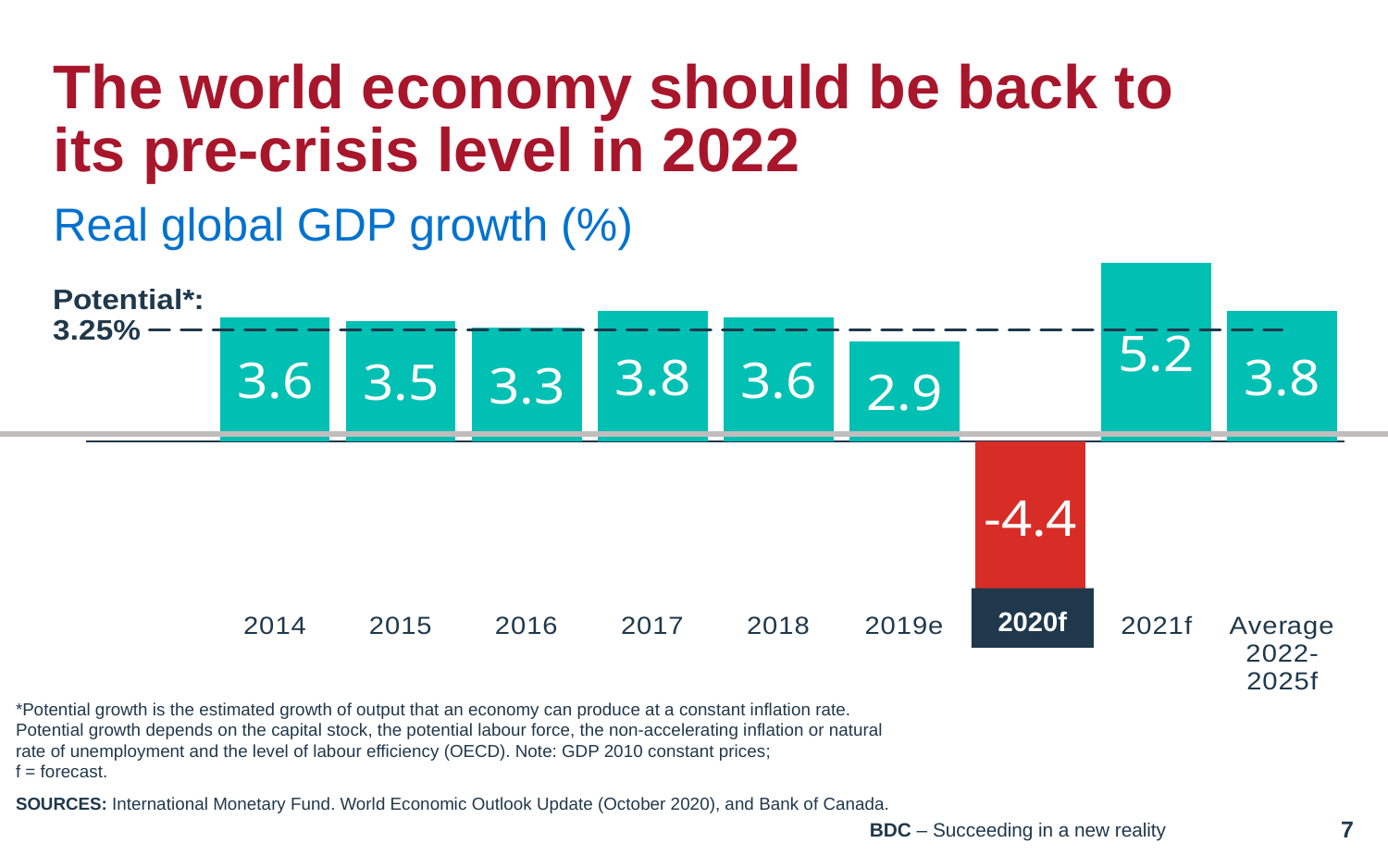
Which bar on the chart is coloured red rather than teal? 2020f Which is larger, the value for 2016 or the value for 2018? 2018 What is the real global GDP growth value shown for 2020f? -4.4 What is the difference between the values for 2021f and 2019e? 2.3 Do the values fall or rise from 2017 to 2019e? fall Which year has the highest real global GDP growth on the chart? 2021f How many categories are shown on the x axis of the chart? 9 What is the value shown for Average 2022-2025f? 3.8 Which year has the lowest real global GDP growth on the chart? 2020f What kind of chart is shown on the slide? bar chart What potential growth rate is marked by the dashed line on the chart? 3.25% What is the real global GDP growth value shown for 2017? 3.8